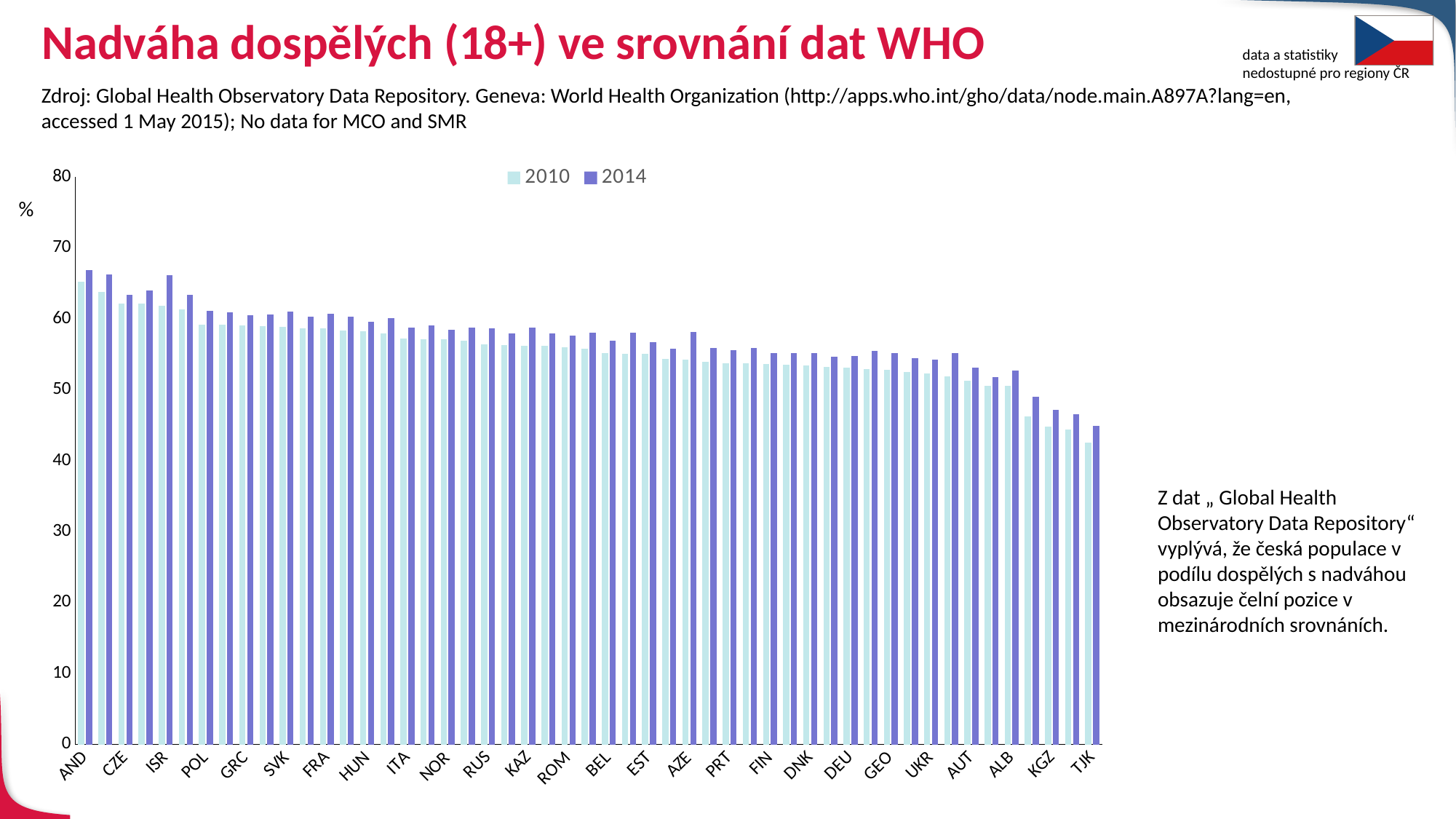
What kind of chart is shown on the slide? bar chart What unit is shown on the vertical axis? % Is the 2014 value for KGZ greater or less than 50? less Is the 2010 value for HUN greater or less than 60? less Which of the labelled countries has the lowest 2010 value? TJK Is the 2014 value for AUT greater or less than 50? greater What are the two series named in the legend? 2010 and 2014 Do the values generally rise or fall moving from left to right along the x axis? fall Which is larger, the 2014 value for ISR or the 2014 value for POL? ISR How many series does the legend list? 2